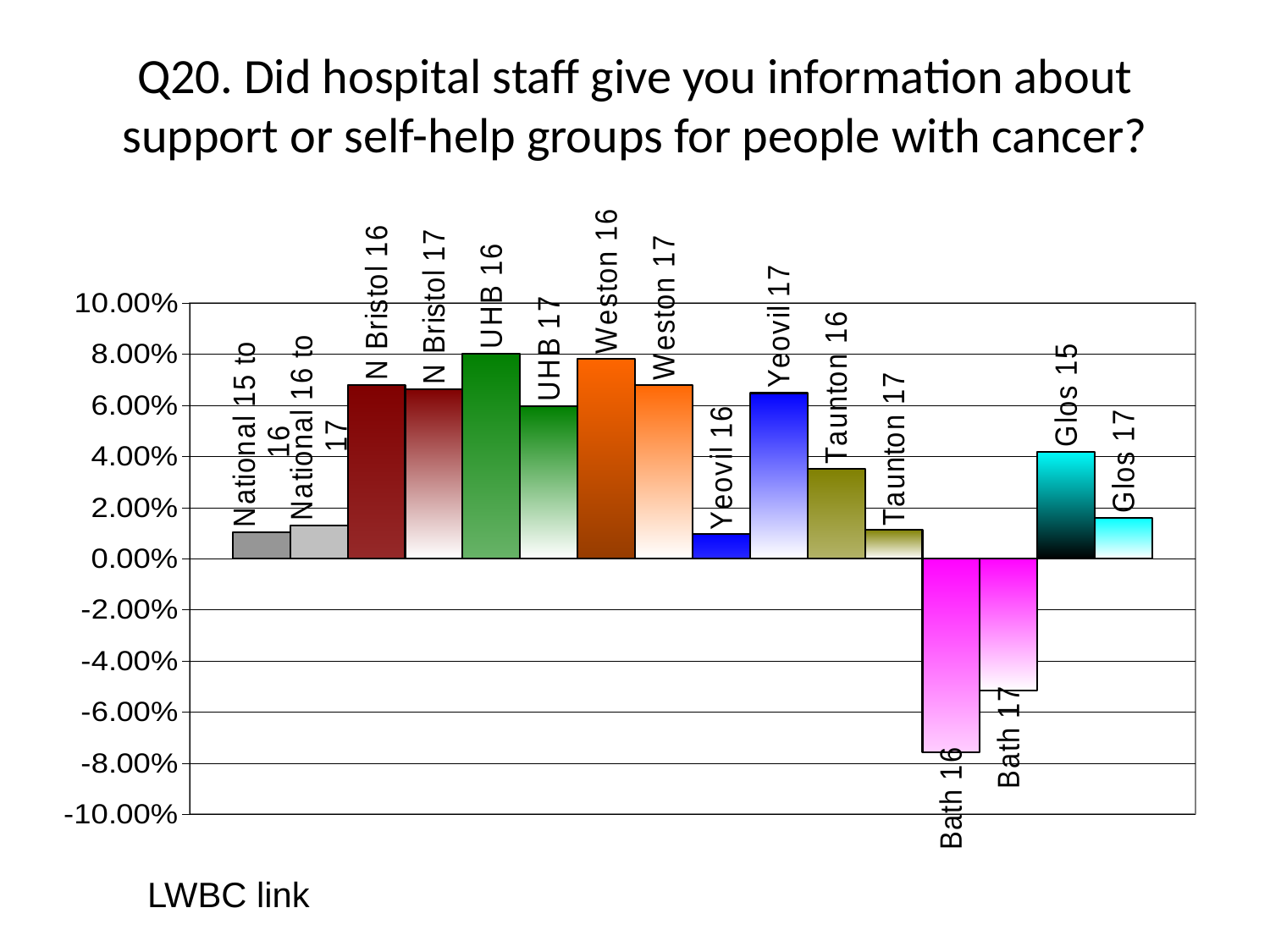
How many bars are plotted in the chart? 16 Which category has the lowest value in the chart? Bath 16 What kind of chart is shown on the slide? bar chart Is the value for Yeovil 17 greater or less than 6.00%? greater Which is larger, the value for Yeovil 16 or Yeovil 17? Yeovil 17 Which is larger, the value for Taunton 16 or Taunton 17? Taunton 16 Which is larger, the value for Glos 15 or Glos 17? Glos 15 Is the value for Bath 17 greater or less than -4.00%? less Is the value for Taunton 16 greater or less than 4.00%? less How many bars in the chart have negative values? 2